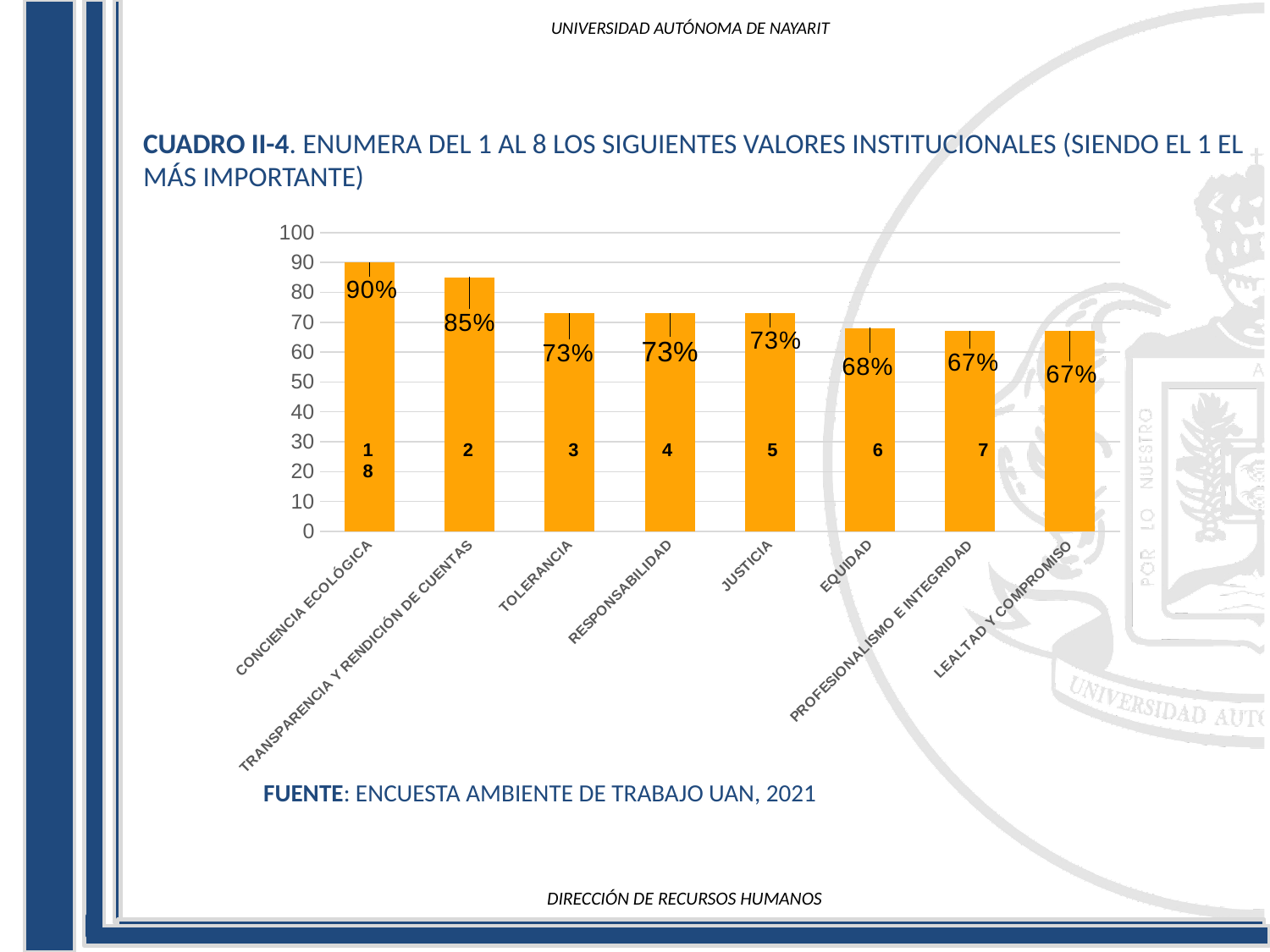
Do the values rise or fall from left to right along the x axis? fall What is the difference between the values for CONCIENCIA ECOLÓGICA and TRANSPARENCIA Y RENDICIÓN DE CUENTAS? 5% What is the difference between the values for JUSTICIA and EQUIDAD? 5% What is the value shown for TRANSPARENCIA Y RENDICIÓN DE CUENTAS? 85% Which is larger, the value for TOLERANCIA or the value for PROFESIONALISMO E INTEGRIDAD? TOLERANCIA Which category has the highest value? CONCIENCIA ECOLÓGICA How many categories are shown on the x axis? 8 Is the value for RESPONSABILIDAD greater or less than 80? less What is the value shown for EQUIDAD? 68% What kind of chart is shown on the slide? bar chart What is the value shown for CONCIENCIA ECOLÓGICA? 90% What is the value shown for LEALTAD Y COMPROMISO? 67%